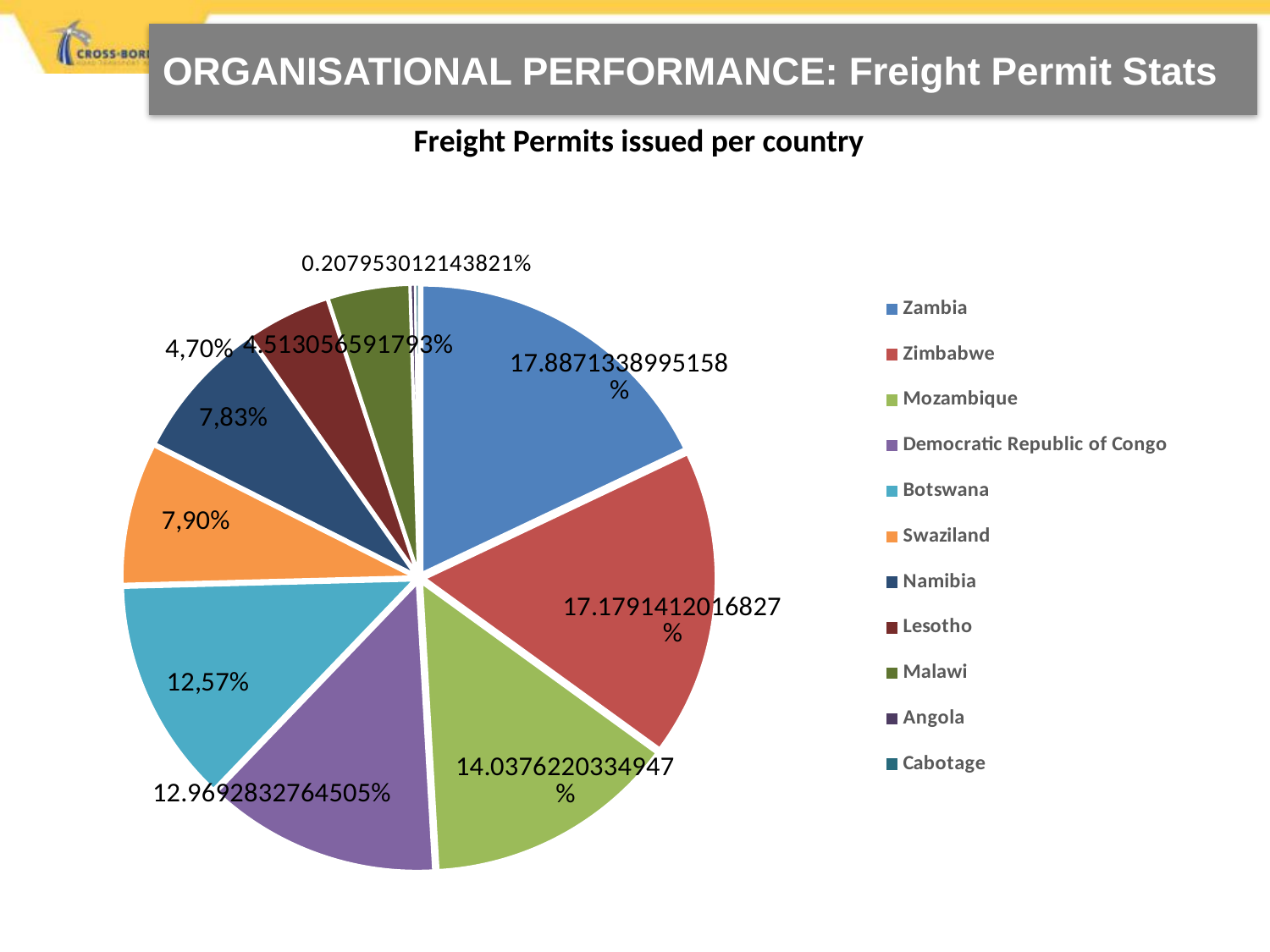
What share of freight permits was issued for Mozambique? 14.0376220334947% What share of freight permits was issued for the Democratic Republic of Congo? 12.9692832764505% How many countries/categories does the legend list? 11 What share of freight permits was issued for Swaziland? 7,90% What share of freight permits was issued for Zimbabwe? 17.1791412016827% What is the difference between the shares for Botswana and Lesotho? 7,87% What type of chart is shown on the slide? Pie chart What share of freight permits was issued for Botswana? 12,57% Which has the larger share of freight permits, Swaziland or Namibia? Swaziland What is the title of the chart? Freight Permits issued per country Which country has the largest share of freight permits issued? Zambia What share of freight permits was issued for Zambia? 17.8871338995158%